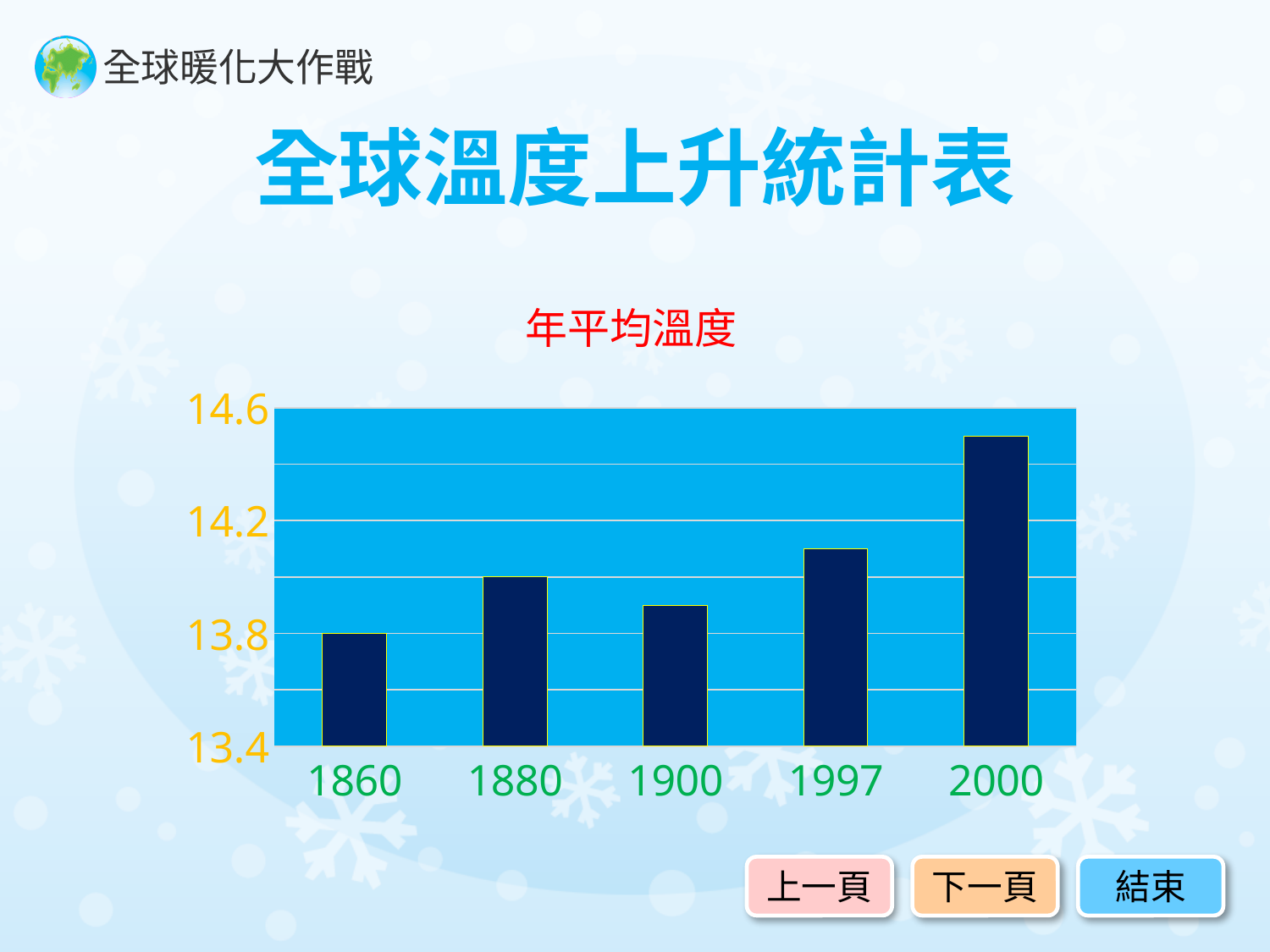
Is the value for 2000 greater or less than 14.2? greater Which is larger, the value for 1997 or the value for 1860? 1997 Which year has the lowest average temperature? 1860 Which is larger, the value for 1880 or the value for 1900? 1880 Is the value for 1900 greater or less than 13.8? greater What is the title of the chart? 年平均溫度 Which year has the highest average temperature? 2000 What is the value for 1860? 13.8 Is the value for 1880 greater or less than 14.2? less What kind of chart is shown on the slide? bar chart How many years (categories) are plotted on the x axis? 5